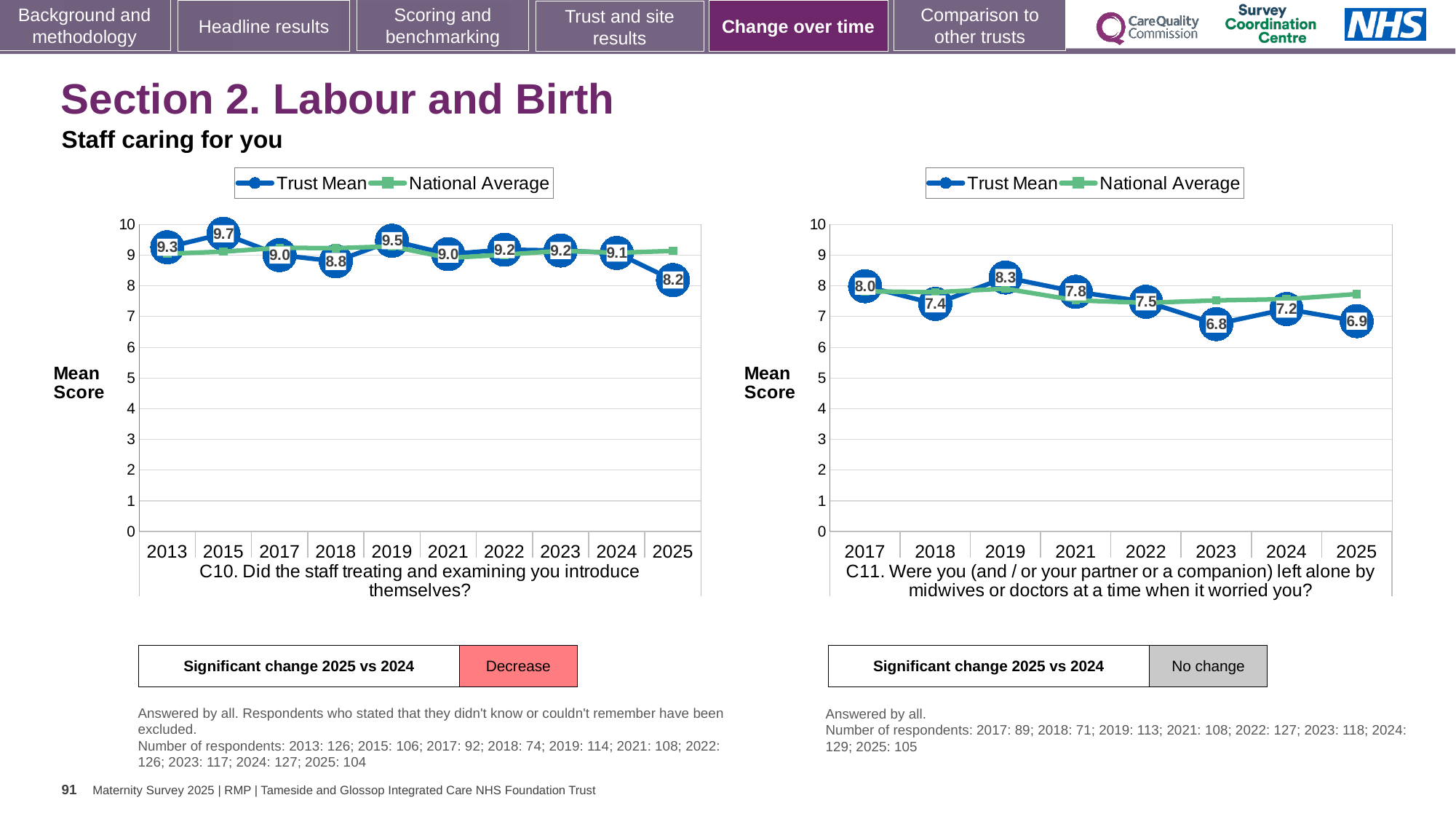
In the C10 chart (left), what is the Trust Mean score for 2015? 9.7 In the C11 chart (right), is the National Average for 2025 greater or less than 7? greater In the C10 chart (left), what is the difference between the Trust Mean scores for 2024 and 2025? 0.9 In the C11 chart (right), which year has the lowest Trust Mean score? 2023 In the C11 chart (right), what is the Trust Mean score for 2019? 8.3 In the C11 chart (right), what is the Trust Mean score for 2023? 6.8 In the C11 chart (right), is the Trust Mean score for 2018 greater or less than the Trust Mean score for 2021? less In the C10 chart (left), what is the Trust Mean score for 2025? 8.2 How many series does the legend of the C11 chart (right) list? 2 In the C10 chart (left), how many years are plotted on the x axis? 10 In the C10 chart (left), which year has the lowest Trust Mean score? 2025 In the C10 chart (left), which year has the highest Trust Mean score? 2015